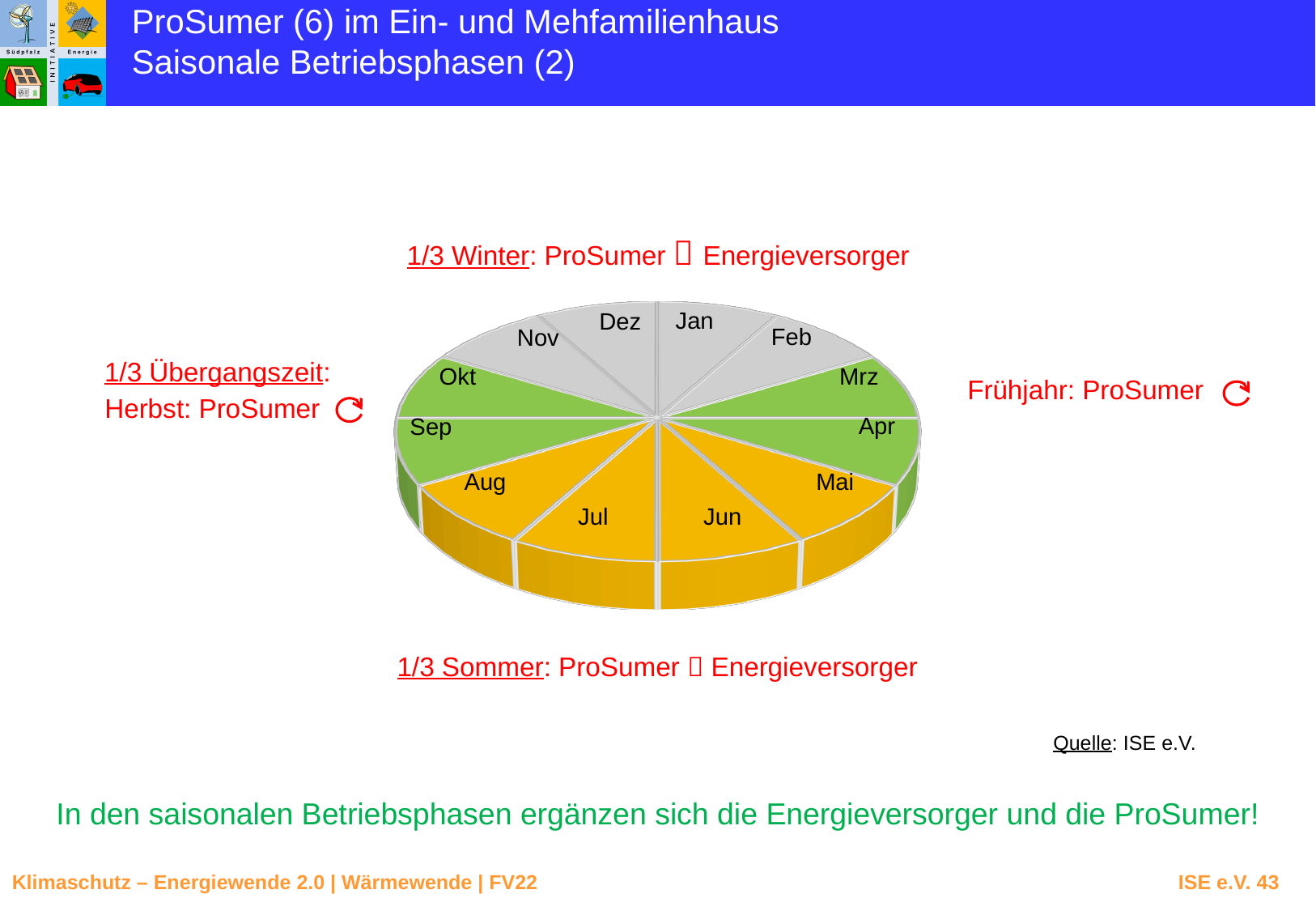
What share of the pie chart does the Übergangszeit (transition period) make up, according to the slide? 1/3 What share of the pie chart do the winter months make up, according to the slide? 1/3 Which slice label appears between Dez and Feb in the pie chart? Jan Which slice label appears between Jun and Aug in the pie chart? Jul What kind of chart is shown on the slide? pie chart Which months are shown in yellow/orange in the pie chart? Mai, Jun, Jul, Aug How many slices does the pie chart have? 12 Which months are shown in grey in the pie chart? Nov, Dez, Jan, Feb What share of the pie chart do the summer months make up, according to the slide? 1/3 How many months are labelled in the pie chart? 12 How many slices of the pie chart are coloured green? 4